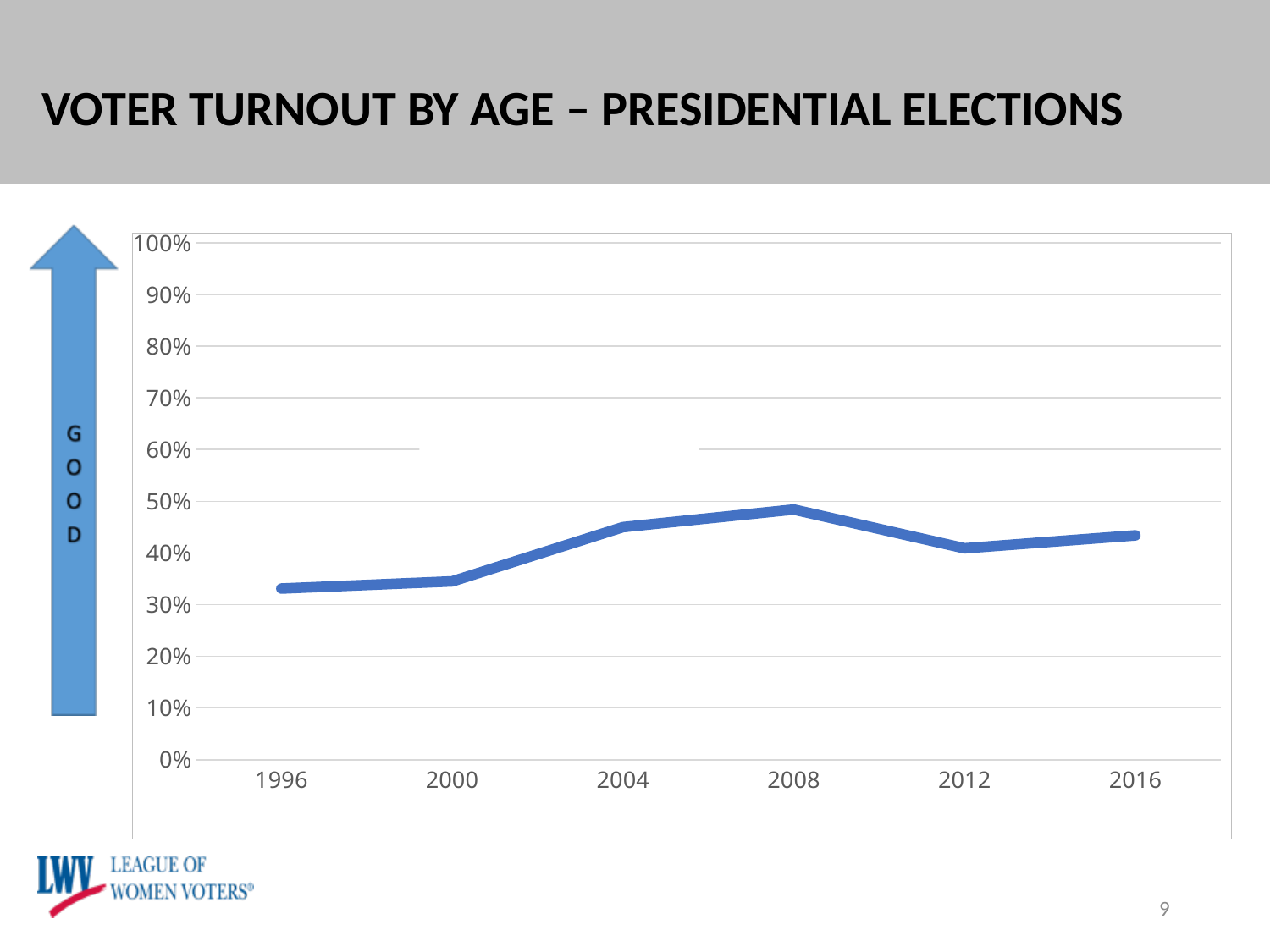
Which has the higher voter turnout, 2008 or 2012? 2008 Is the value for 1996 greater or less than 40%? less Is the value for 2008 greater or less than 50%? less Does voter turnout rise or fall from 1996 to 2008? rise Which has the higher voter turnout, 1996 or 2004? 2004 How many election years are plotted on the x axis? 6 What is the title of the slide containing the chart? VOTER TURNOUT BY AGE – PRESIDENTIAL ELECTIONS Is the value for 2000 greater or less than 40%? less Which election year has the highest voter turnout on the chart? 2008 What kind of chart is shown on the slide? Line chart